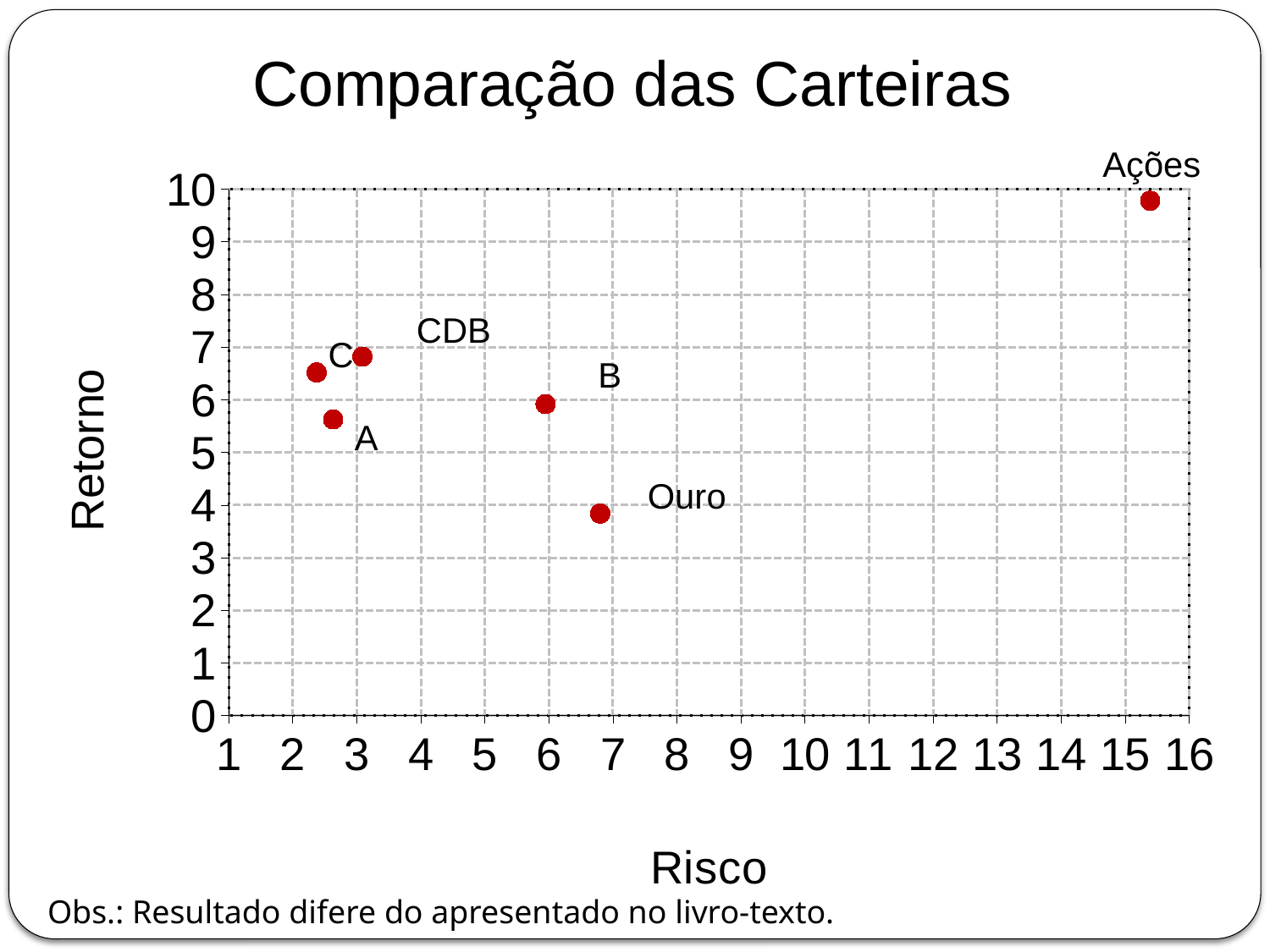
Is the Retorno for Ações greater or less than 9? greater Which portfolio has the highest Risco? Ações Is the Risco for B greater or less than 5? greater Which portfolio has the highest Retorno? Ações Which has the higher Retorno, B or Ouro? B What kind of chart is shown on the slide? scatter chart What is the title of the chart? Comparação das Carteiras How many portfolios (points) are plotted on the chart? 6 Is the Retorno for Ouro greater or less than 5? less What are the labels of the x axis and the y axis? Risco (x axis) and Retorno (y axis) Which portfolio has the lowest Retorno? Ouro